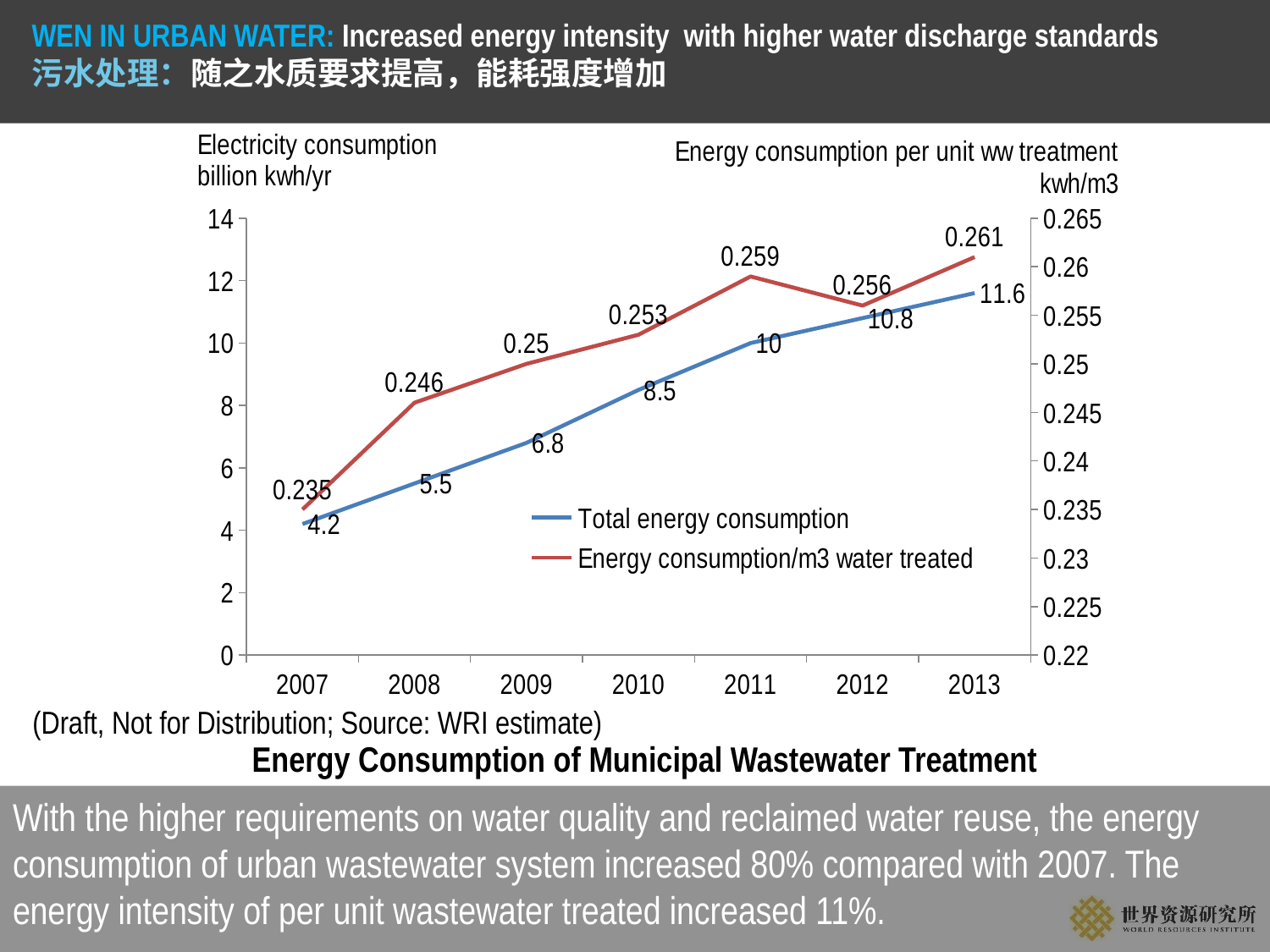
What is the Energy consumption/m3 water treated value for 2011? 0.259 In which year is Energy consumption/m3 water treated lowest? 2007 Which year has a higher Energy consumption/m3 water treated value, 2011 or 2012? 2011 What is the difference in Total energy consumption between 2013 and 2007? 7.4 How many years are shown on the x axis? 7 Does Total energy consumption rise or fall from 2007 to 2013? Rise What is the Total energy consumption value for 2007? 4.2 In which year is Total energy consumption highest? 2013 How many series does the legend list? 2 What is the Total energy consumption value for 2010? 8.5 What is the difference in Energy consumption/m3 water treated between 2012 and 2011? 0.003 What kind of chart is shown on the slide? Line chart